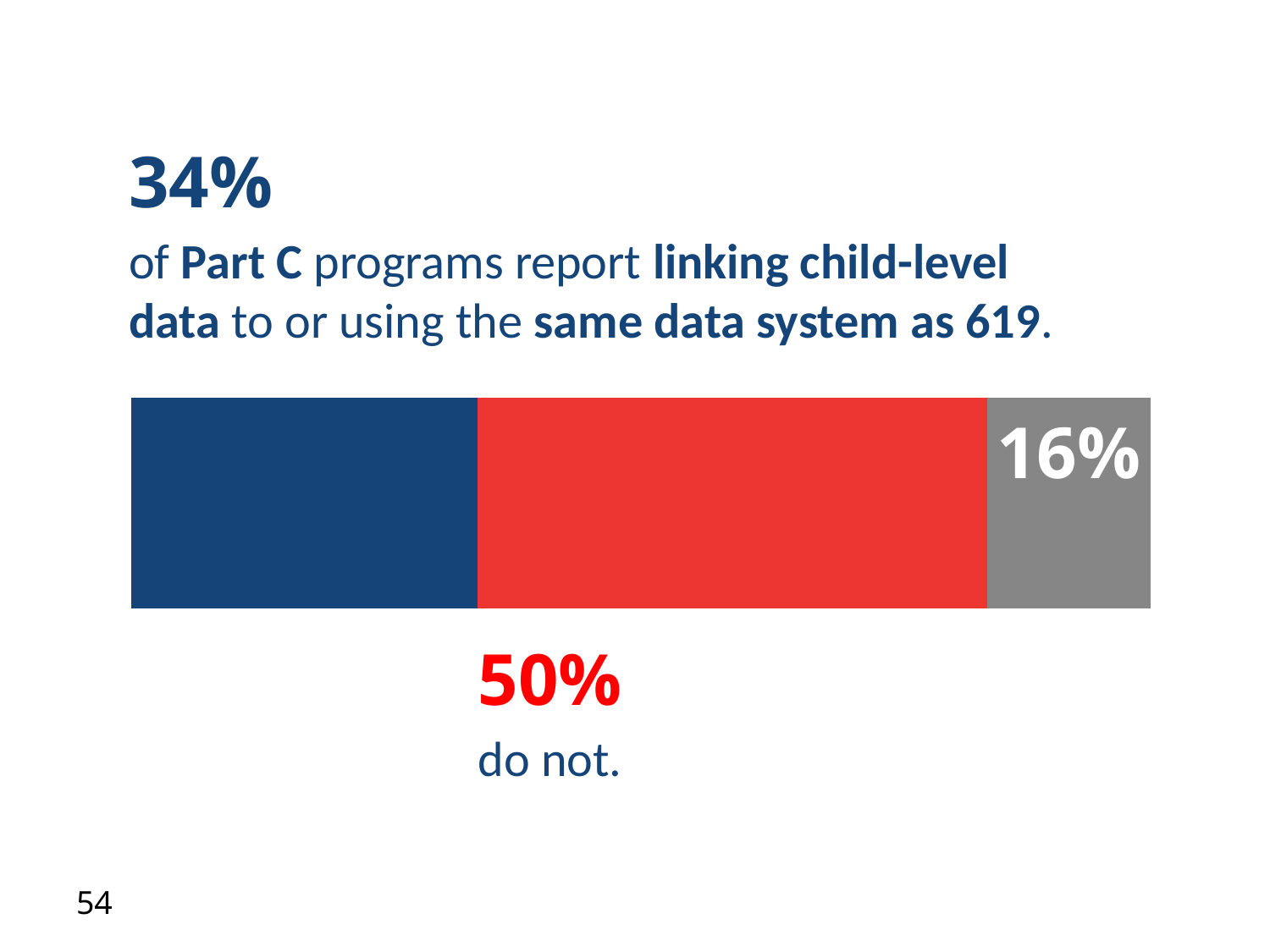
Which is larger: the share of Part C programs that link child-level data (34%) or the share that do not (50%)? The share that do not (50%) What is the difference between the red segment (50%) and the blue segment (34%)? 16 percentage points What value is printed on the gray segment at the right end of the bar? 16% Which segment of the bar has the smallest value? The gray segment (16%) What percentage of Part C programs do not link child-level data or use the same data system as 619, as shown by the red segment? 50% What is the total of the three segments in the bar (34%, 50% and 16%)? 100% What colour is the segment representing the 34% of Part C programs that link child-level data? Blue How many segments make up the stacked bar? 3 What kind of chart is shown on the slide? A stacked bar chart What percentage of Part C programs report linking child-level data to or using the same data system as 619, as shown by the blue segment of the bar? 34% What colour is the segment representing the 50% of Part C programs that do not link child-level data? Red Which segment of the bar has the largest value? The red segment (50%, do not)